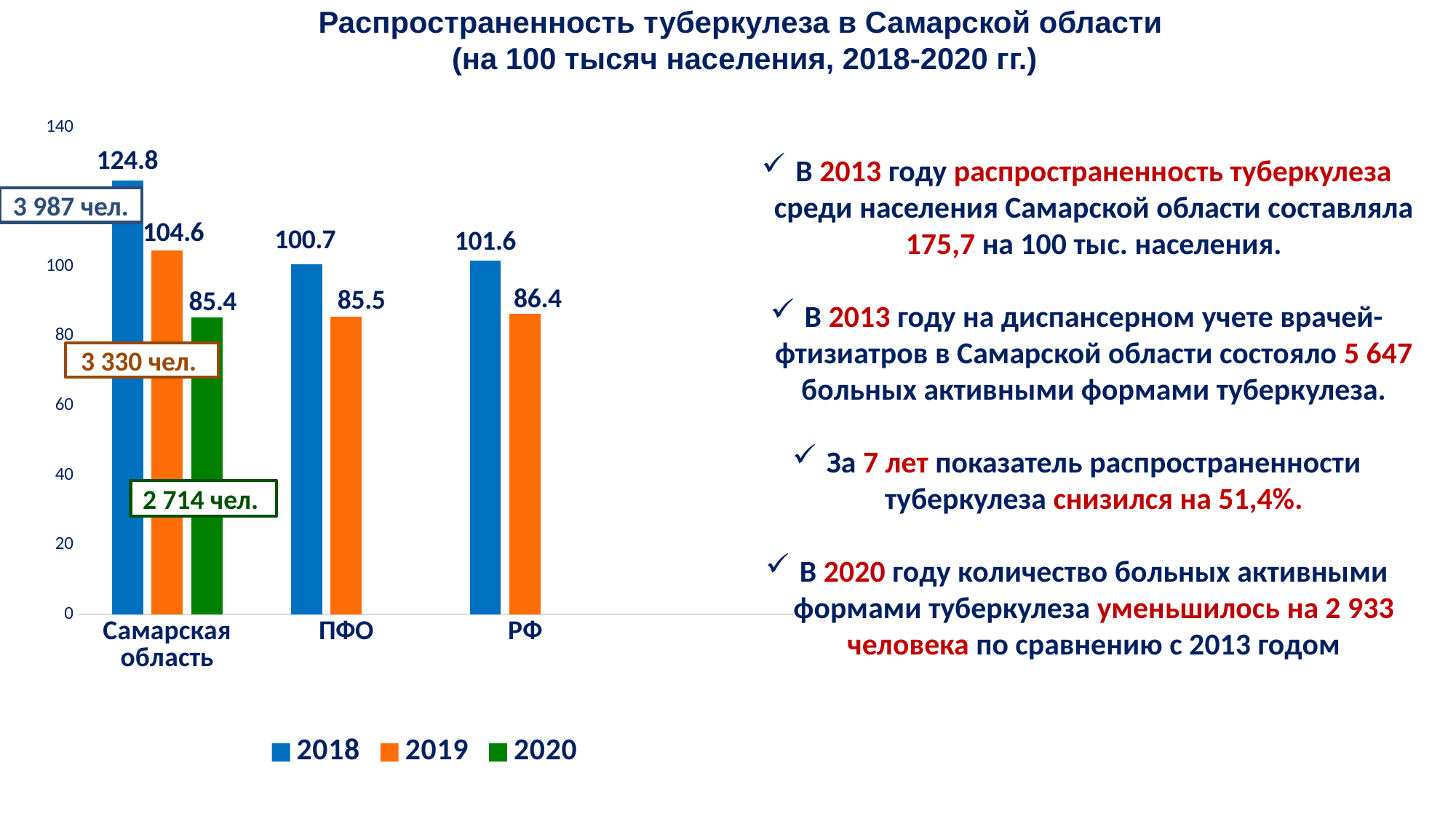
Which category has the lowest 2019 value? ПФО How many series does the legend list? 3 Which category has the highest 2018 value? Самарская область Which category has a bar for the 2020 series? Самарская область How many categories are shown on the x axis? 3 What is the 2018 value for Самарская область? 124.8 What is the 2018 value for РФ? 101.6 What kind of chart is shown on the slide? bar chart What is the 2020 value for Самарская область? 85.4 Which is larger: the 2018 value for ПФО or the 2018 value for РФ? РФ What is the 2019 value for ПФО? 85.5 What is the difference between the 2018 and 2019 values for Самарская область? 20.2